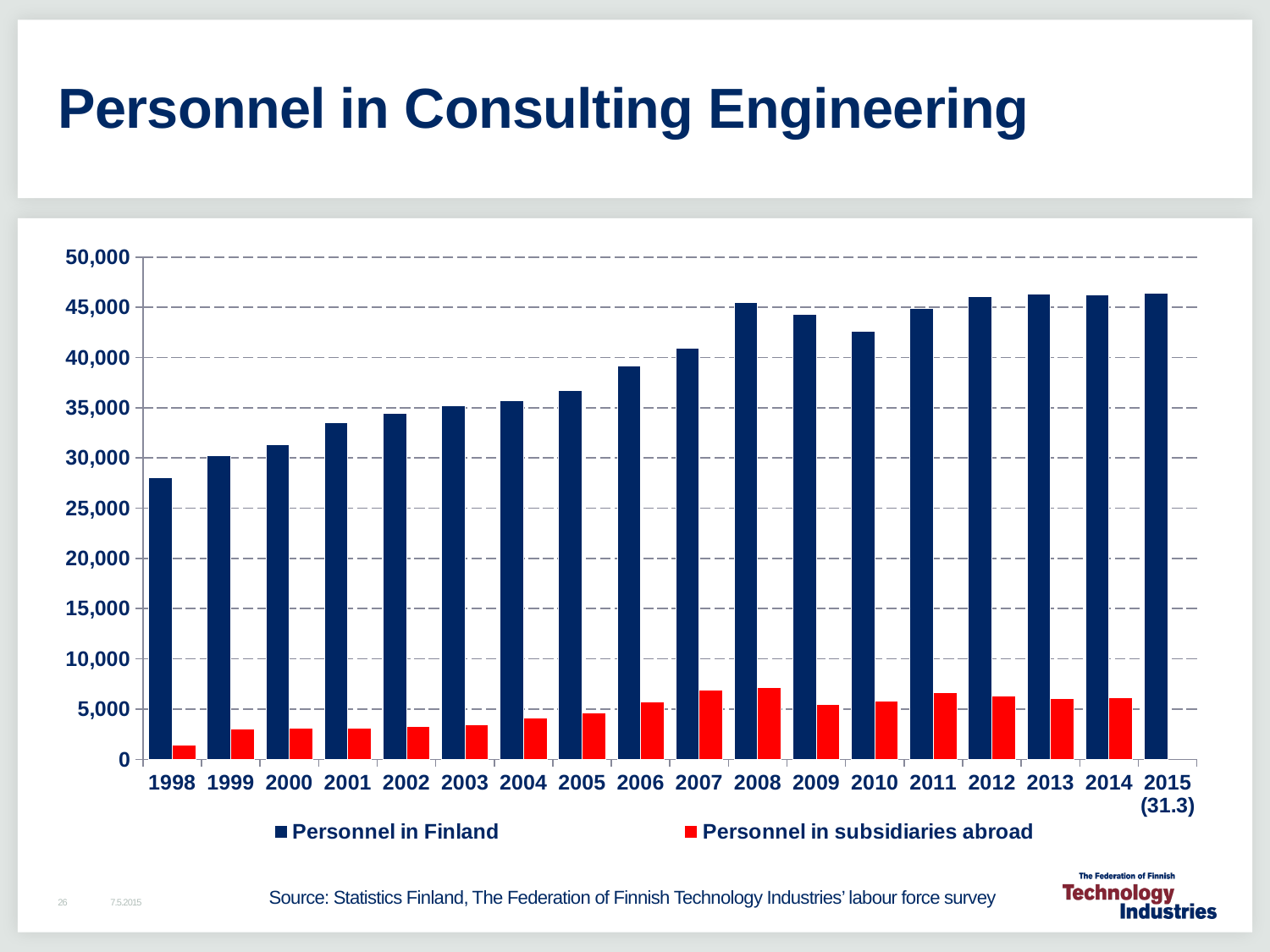
Is the value for Personnel in Finland in 2010 greater or less than 45,000? less Which year has the lowest value for Personnel in subsidiaries abroad? 1998 How many series does the legend list? 2 Which year has the lowest value for Personnel in Finland? 1998 Is the value for Personnel in Finland in 2001 greater or less than 30,000? greater What kind of chart is shown on the slide? bar chart Is the value for Personnel in Finland in 1998 greater or less than 30,000? less Which is larger for Personnel in Finland, 2009 or 2010? 2009 How many years are shown on the x axis? 18 Overall, do the values for Personnel in Finland rise or fall from 1998 to 2015? rise